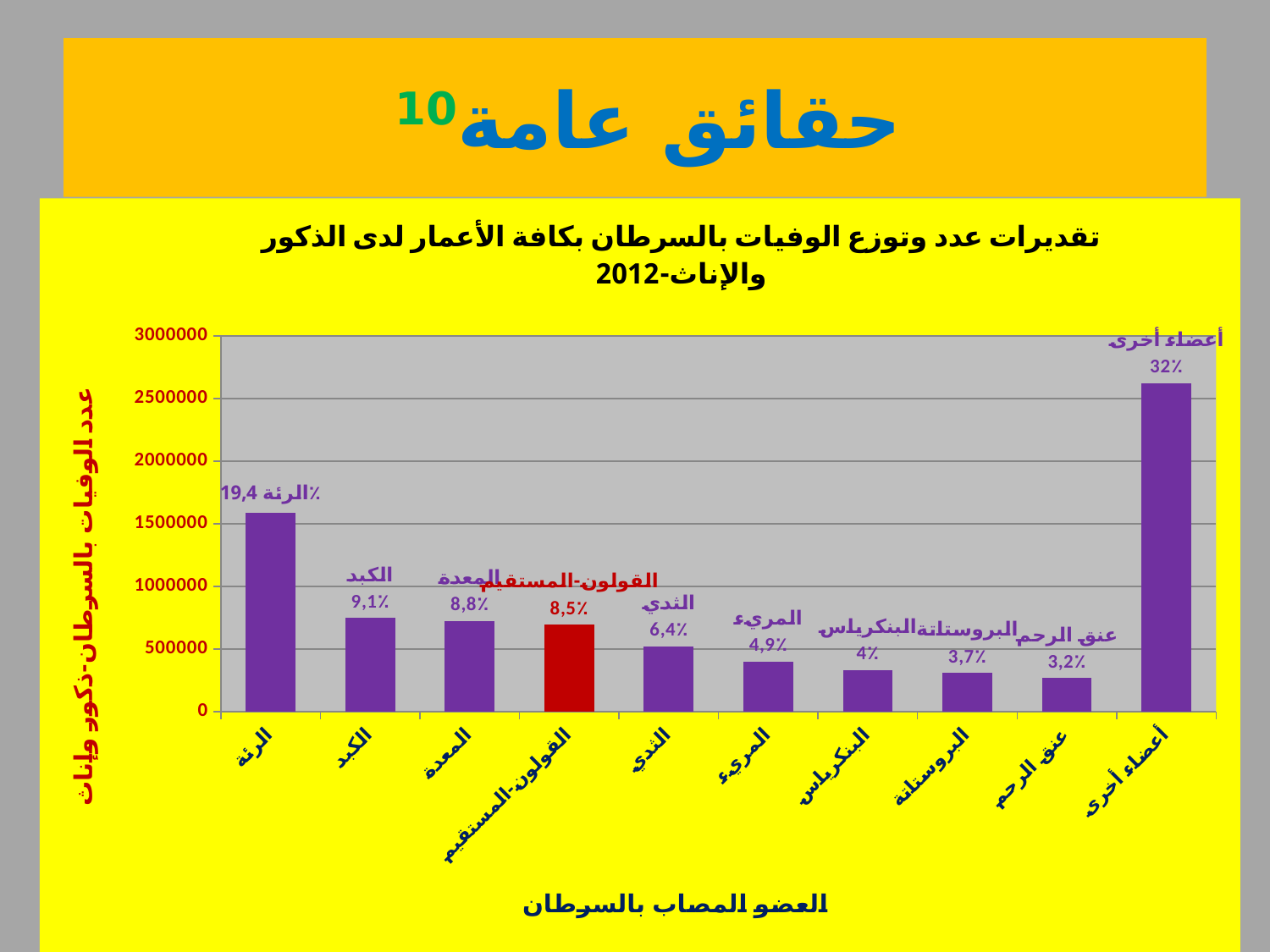
Which bar in the chart is coloured red instead of purple? القولون-المستقيم Is the value for البنكرياس greater or less than 500000? less What percentage label is shown for القولون-المستقيم (colon-rectum)? 8,5% What kind of chart is shown on the slide? bar chart Which category has the tallest bar in the chart? أعضاء أخرى Is the value for الرئة greater or less than 1500000? greater Which category has the shortest bar in the chart? عنق الرحم What percentage label is shown for الرئة (lung)? 19,4% Which has a larger value, الكبد or الثدي? الكبد What percentage label is shown for الكبد (liver)? 9,1% What percentage label is shown for عنق الرحم (cervix)? 3,2% How many categories (organs) are shown on the x axis of the chart? 10